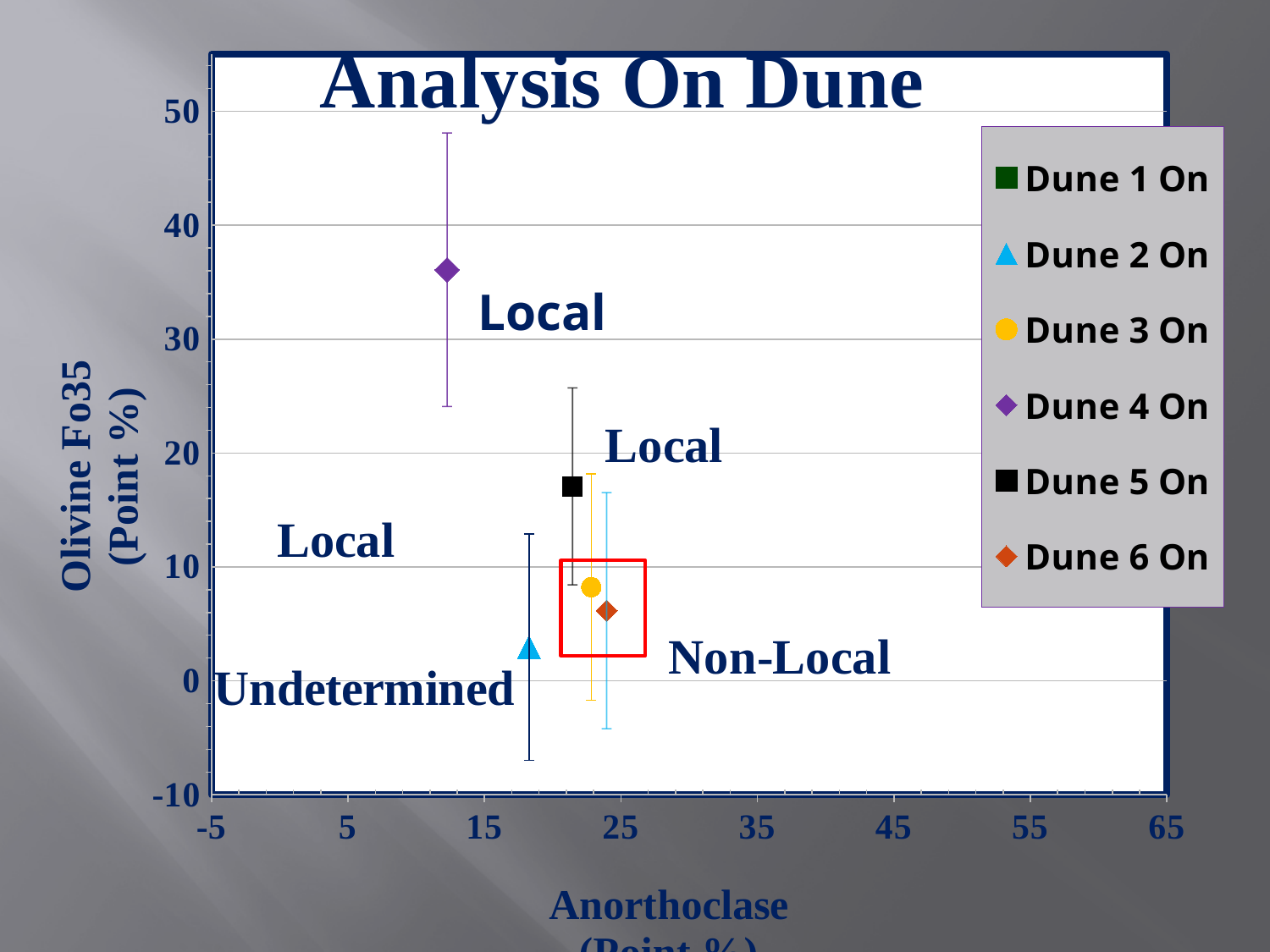
What is the label of the vertical axis? Olivine Fo35 (Point %) Which series has the highest Olivine Fo35 value? Dune 4 On Is the Olivine Fo35 value for Dune 4 On greater or less than 30? greater Is the Olivine Fo35 value for Dune 5 On greater or less than 20? less Which plotted series has the lowest Olivine Fo35 value? Dune 2 On Which has the higher Olivine Fo35 value, Dune 5 On or Dune 3 On? Dune 5 On Is the Olivine Fo35 value for Dune 2 On greater or less than 10? less What kind of chart is shown on the slide? scatter chart Which has the higher Anorthoclase value, Dune 4 On or Dune 5 On? Dune 5 On How many series does the legend list? 6 What is the title of the chart? Analysis On Dune